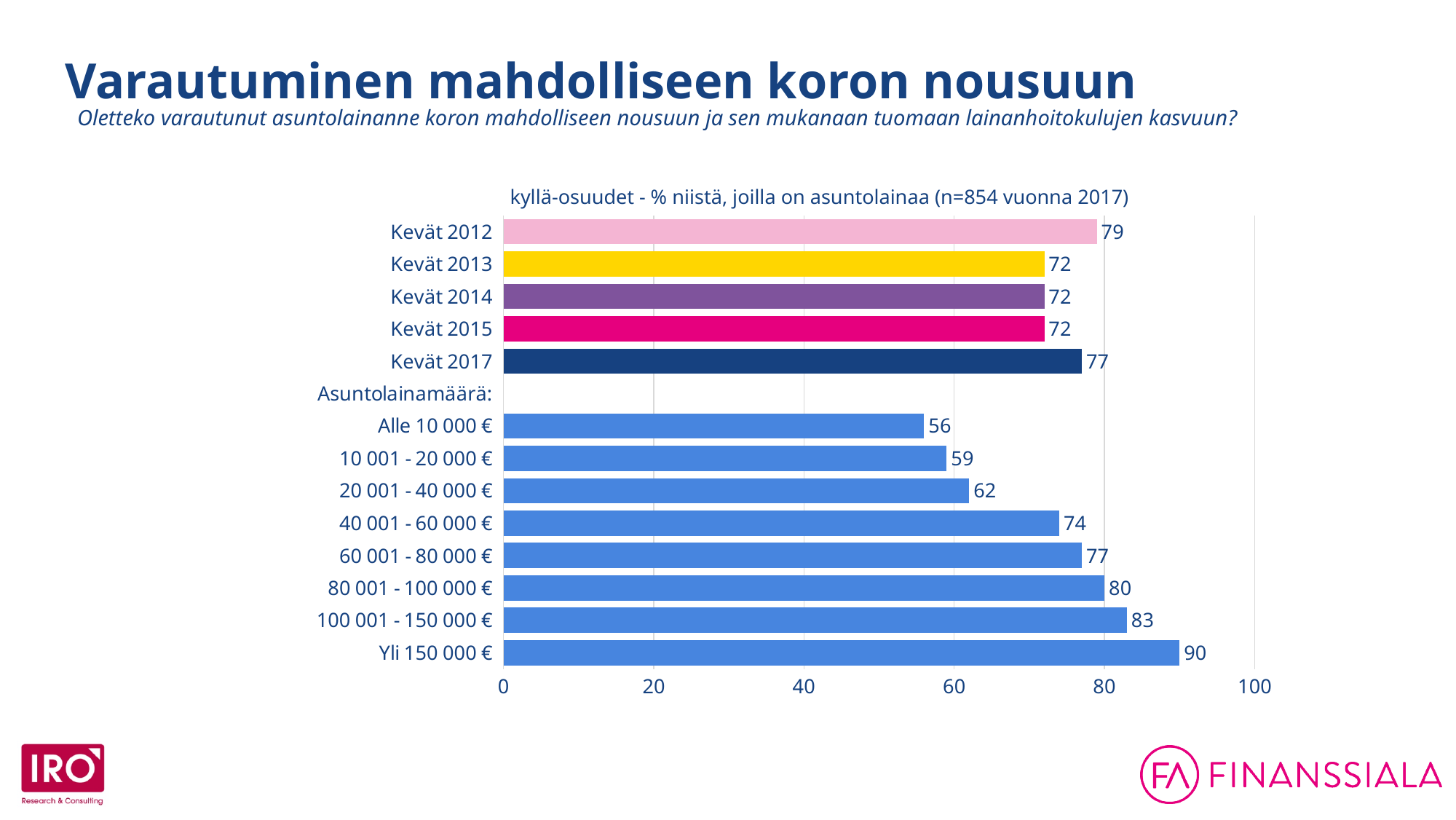
Do the values rise or fall as the loan amount categories increase from Alle 10 000 € to Yli 150 000 €? Rise What is the difference between the values for Yli 150 000 € and Alle 10 000 €? 34 Which loan amount category has the lowest value? Alle 10 000 € What is the value for Kevät 2012? 79 What is the value for the loan amount category Alle 10 000 €? 56 Which loan amount category has the highest value? Yli 150 000 € What is the value for the loan amount category Yli 150 000 €? 90 How many loan amount categories (Asuntolainamäärä) have bars in the chart? 8 What is the difference between the values for Kevät 2012 and Kevät 2017? 2 Which is larger, the value for 80 001 - 100 000 € or the value for 40 001 - 60 000 €? 80 001 - 100 000 € What kind of chart is shown on the slide? Bar chart What is the value for Kevät 2017? 77